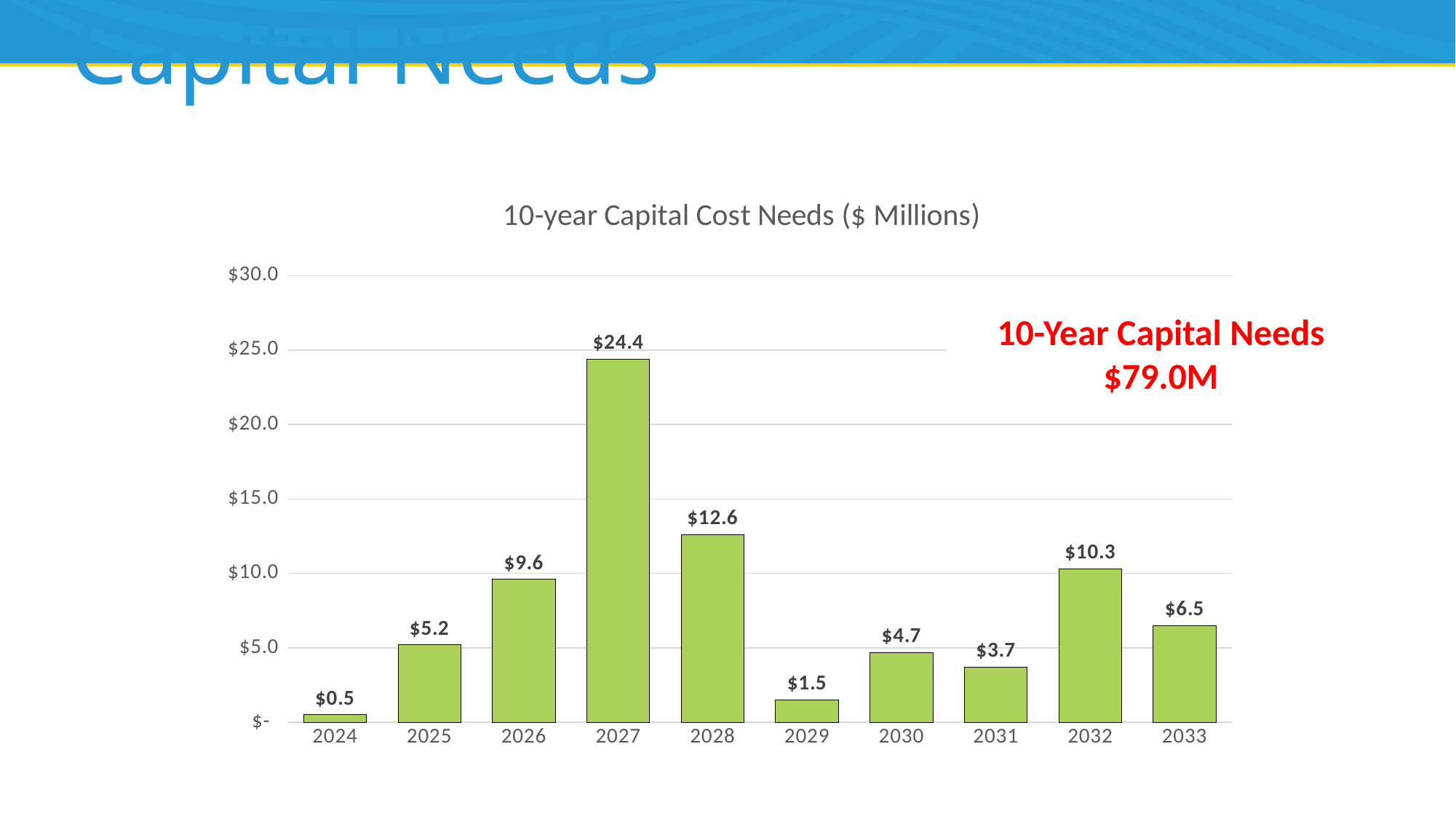
What is the capital cost need for 2032? $10.3 Do the values rise or fall from 2024 to 2027? Rise What kind of chart is shown on the slide? Bar chart Is the value for 2028 greater or less than $10.0? greater How many years are shown on the x axis? 10 What is the difference between the capital cost needs for 2027 and 2028? $11.8 What is the capital cost need for 2027? $24.4 What is the title of the chart? 10-year Capital Cost Needs ($ Millions) What is the capital cost need for 2024? $0.5 Which year has the lowest capital cost need? 2024 Which year has the highest capital cost need? 2027 Which year has a larger capital cost need, 2026 or 2033? 2026